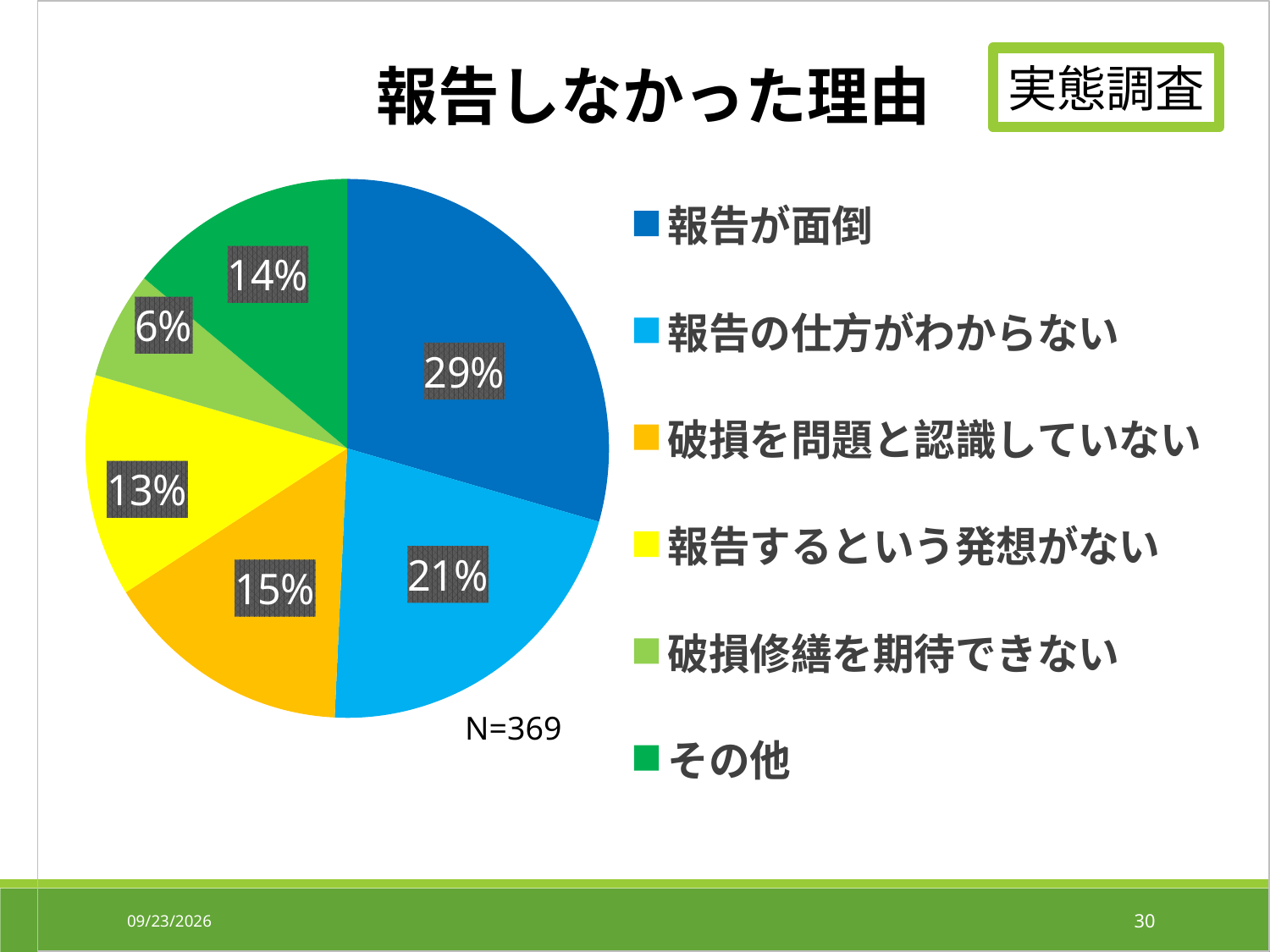
Which category has the smallest slice of the pie? 破損修繕を期待できない What percentage is shown for 破損修繕を期待できない? 6% How many categories does the pie chart show? 6 What percentage is shown for その他? 14% What share of the pie does 報告が面倒 account for? 29% What is the difference in percentage points between 報告が面倒 and 報告の仕方がわからない? 8 What type of chart is shown on the slide? Pie chart What percentage is shown for 破損を問題と認識していない? 15% Which category has the largest slice of the pie? 報告が面倒 Which is larger, the slice for 破損を問題と認識していない or the slice for 報告するという発想がない? 破損を問題と認識していない What percentage is shown for 報告するという発想がない? 13% What percentage is shown for 報告の仕方がわからない? 21%